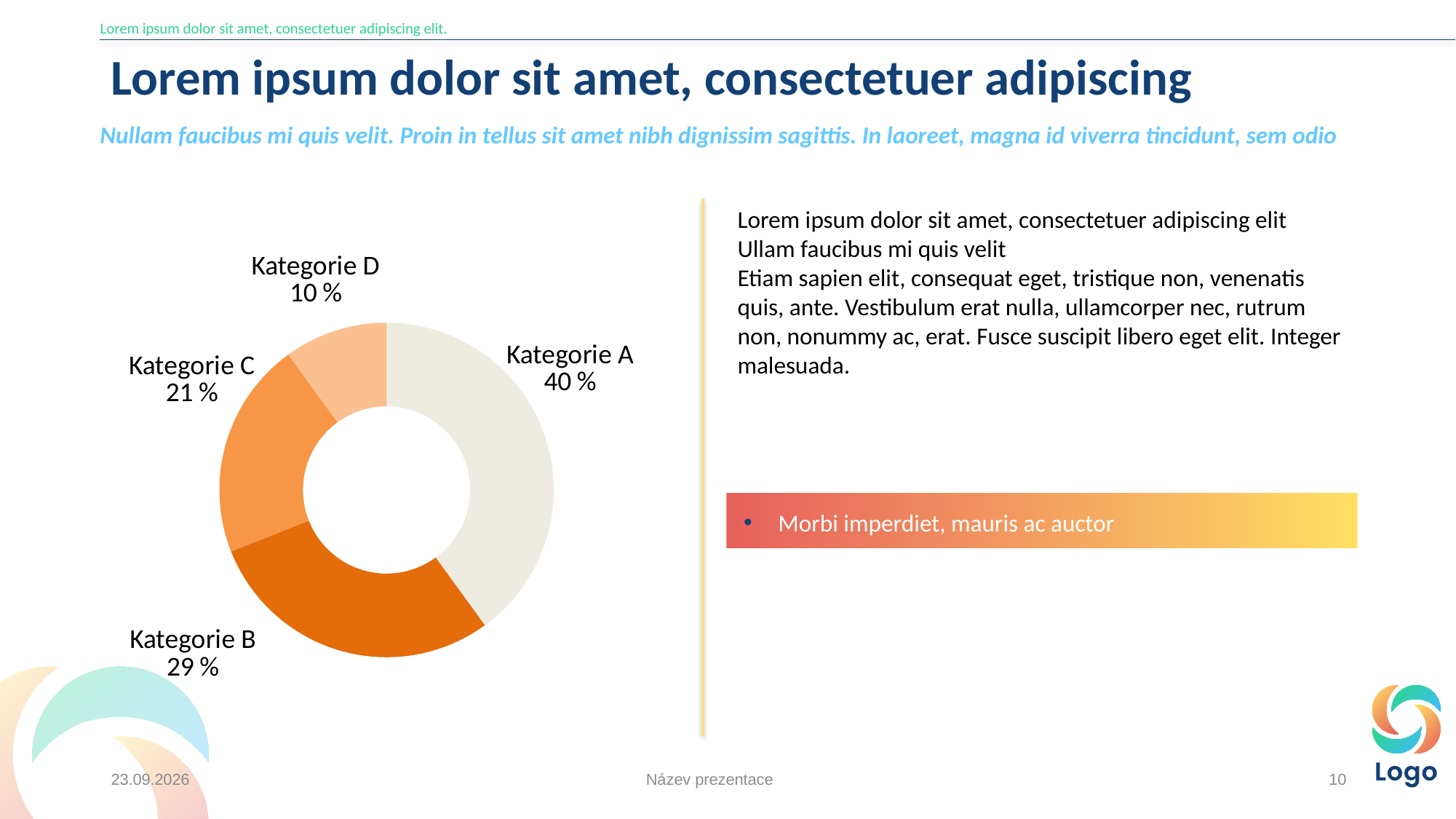
What is the combined share of Kategorie B and Kategorie C? 50 % What is the value for Kategorie D? 10 % Which category has the largest share? Kategorie A Which category is shown in the lightest, beige-grey colour? Kategorie A Which is larger, the share of Kategorie C or Kategorie D? Kategorie C What is the value for Kategorie A? 40 % What is the difference between the shares of Kategorie A and Kategorie B? 11 % How many categories are shown in the chart? 4 What is the value for Kategorie C? 21 % What kind of chart is shown on the slide? Doughnut chart Which category has the smallest share? Kategorie D What is the value for Kategorie B? 29 %